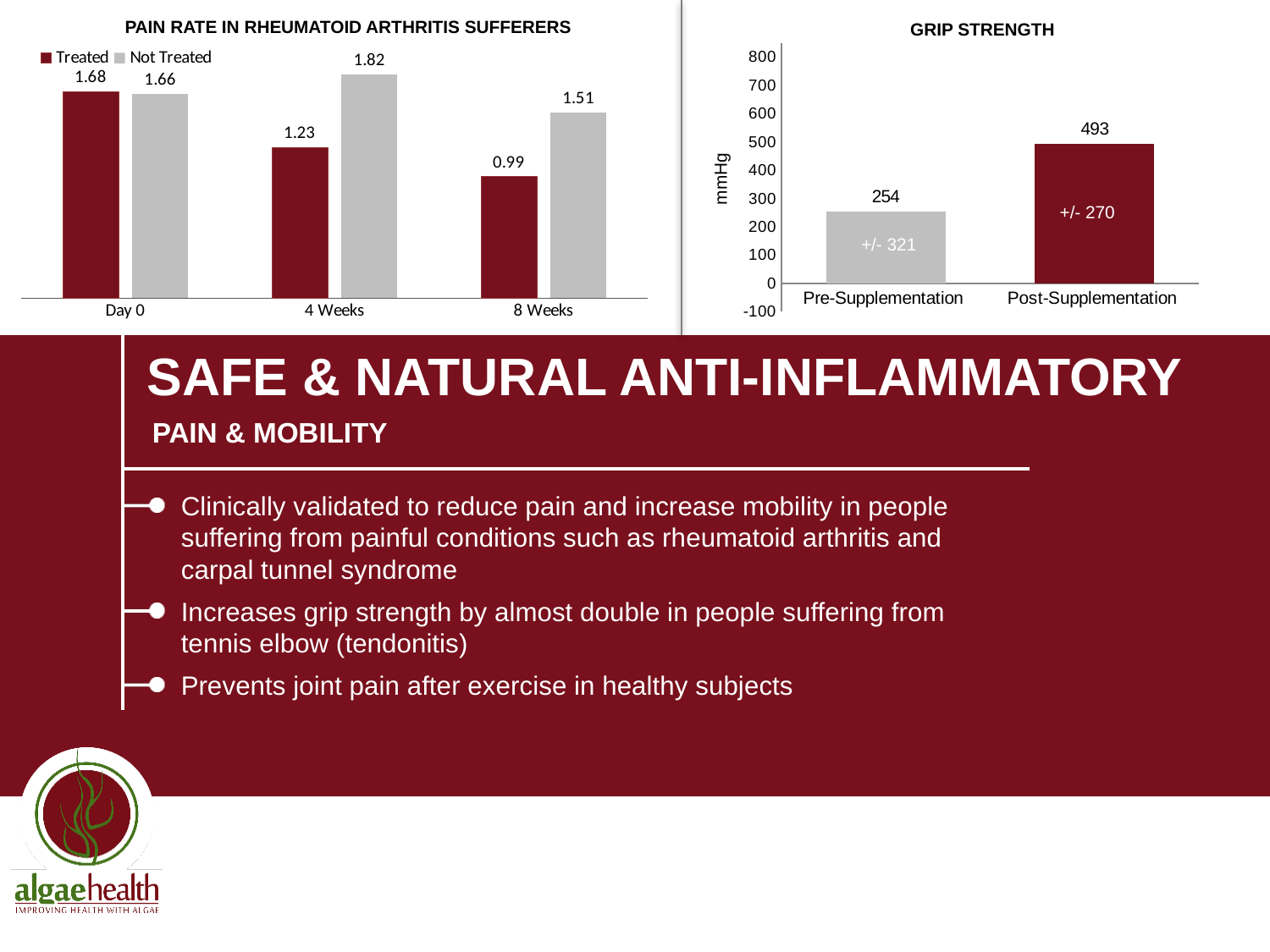
In the PAIN RATE IN RHEUMATOID ARTHRITIS SUFFERERS chart, what is the difference between Not Treated and Treated at 8 Weeks? 0.52 In the PAIN RATE IN RHEUMATOID ARTHRITIS SUFFERERS chart, how do the Treated values change from Day 0 to 8 Weeks? They fall In the GRIP STRENGTH chart, what is the difference between Post-Supplementation and Pre-Supplementation? 239 In the GRIP STRENGTH chart, what is the value for Post-Supplementation? 493 In the PAIN RATE IN RHEUMATOID ARTHRITIS SUFFERERS chart, how many series does the legend list? 2 In the PAIN RATE IN RHEUMATOID ARTHRITIS SUFFERERS chart, what is the value for Treated at 4 Weeks? 1.23 In the PAIN RATE IN RHEUMATOID ARTHRITIS SUFFERERS chart, how many time points are shown on the x axis? 3 What kind of chart is the GRIP STRENGTH chart? Bar chart In the PAIN RATE IN RHEUMATOID ARTHRITIS SUFFERERS chart, at which time point is the Treated value lowest? 8 Weeks In the GRIP STRENGTH chart, which is larger, Pre-Supplementation or Post-Supplementation? Post-Supplementation In the PAIN RATE IN RHEUMATOID ARTHRITIS SUFFERERS chart, at which time point is the Not Treated value highest? 4 Weeks In the PAIN RATE IN RHEUMATOID ARTHRITIS SUFFERERS chart, what is the value for Not Treated at 8 Weeks? 1.51